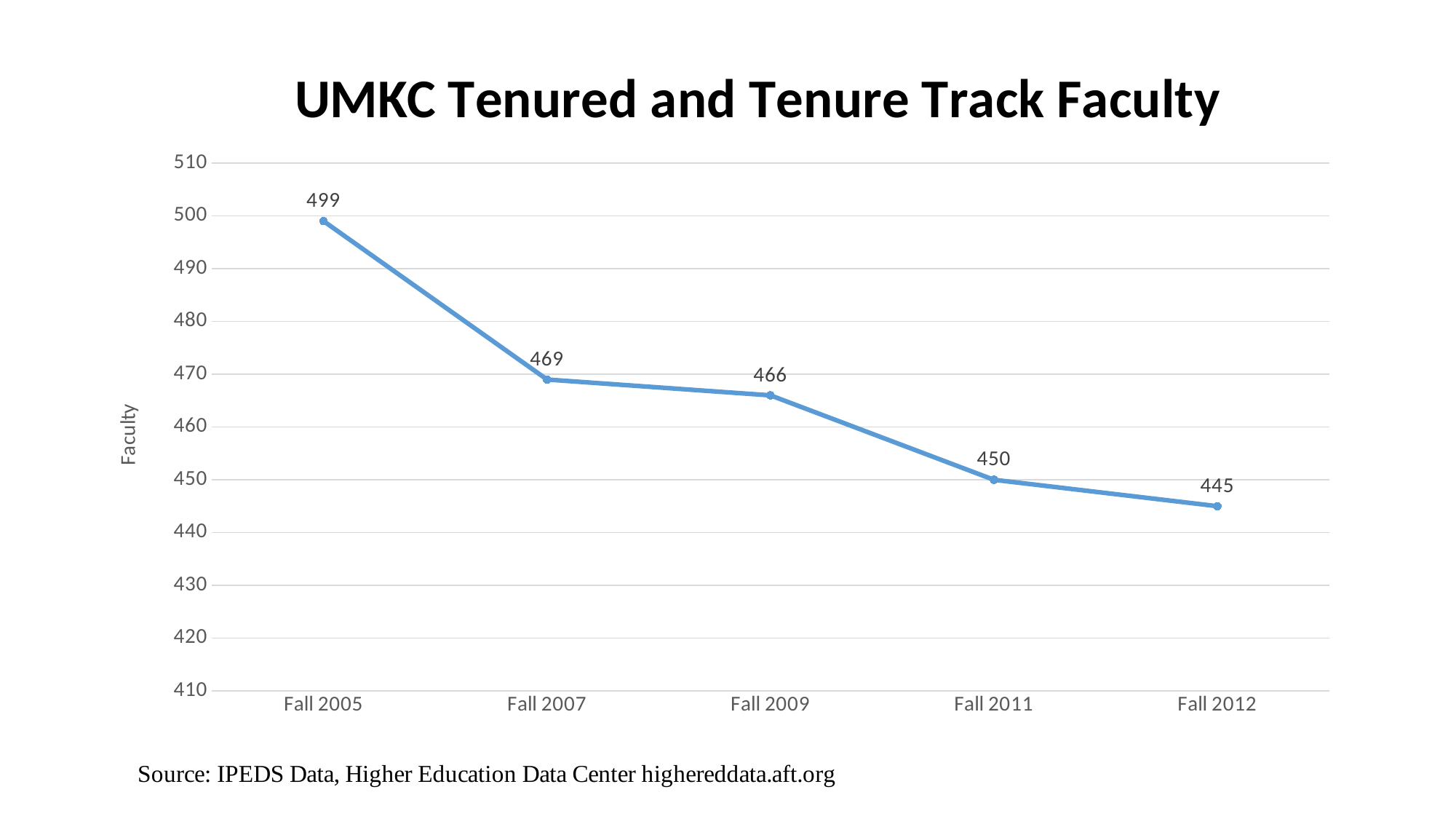
Which is larger, the value for Fall 2007 or the value for Fall 2009? Fall 2007 What is the value for Fall 2009? 466 Which period has the highest faculty count? Fall 2005 What kind of chart is shown on the slide? line chart What is the difference between the Fall 2007 and Fall 2011 values? 19 Do the values rise or fall from Fall 2005 to Fall 2012? fall Which period has the lowest faculty count? Fall 2012 What is the value for Fall 2012? 445 What is the difference between the Fall 2005 and Fall 2012 values? 54 How many data points are plotted on the chart? 5 Is the value for Fall 2011 greater or less than 460? less What is the number of tenured and tenure track faculty in Fall 2005? 499